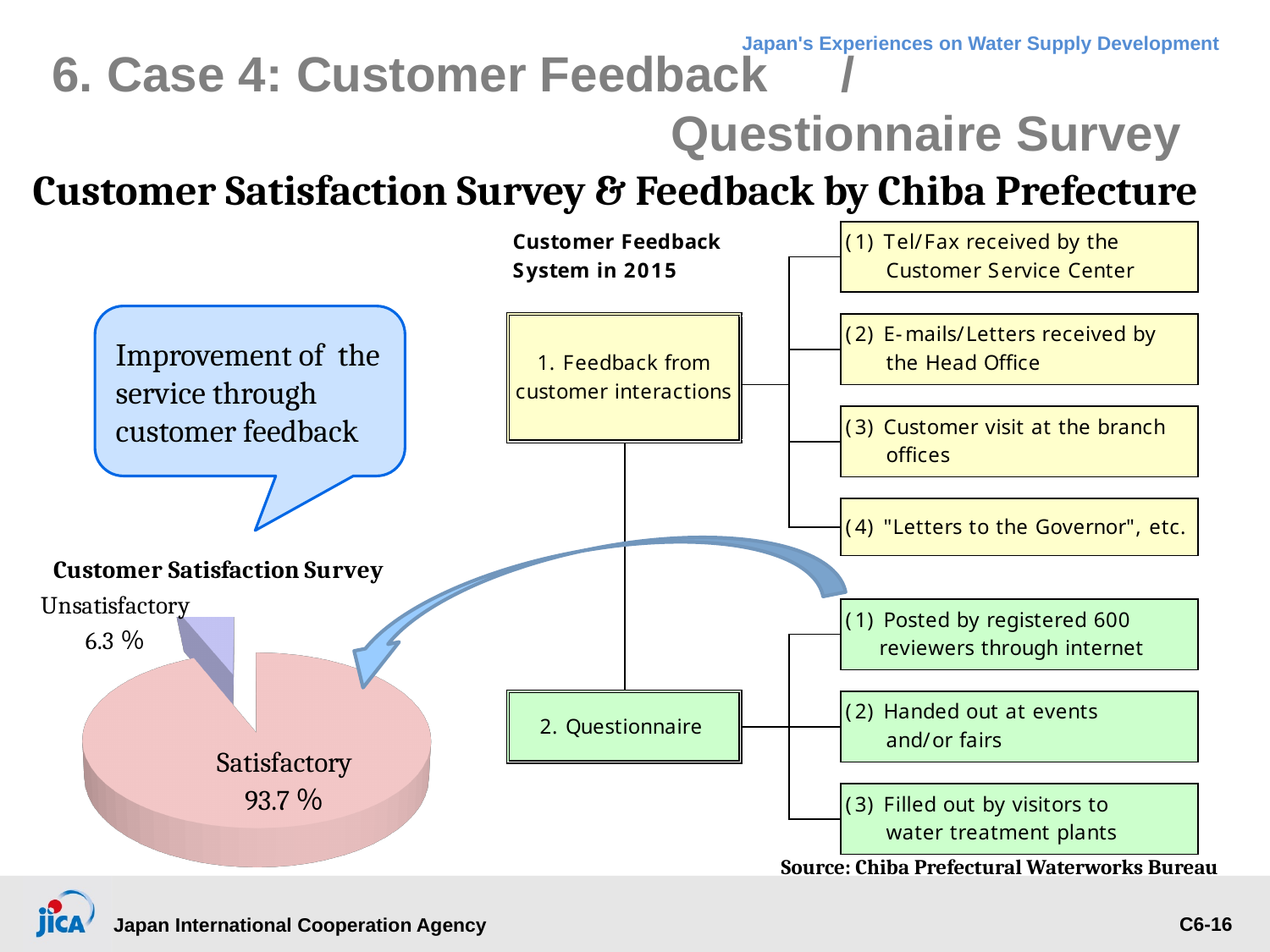
Which slice of the pie chart is the smallest? Unsatisfactory Is the Unsatisfactory share of the pie chart greater or less than 10%? less How many slices does the pie chart have? 2 What is the difference in percentage points between the Satisfactory and Unsatisfactory slices? 87.4 What is the title shown above the pie chart? Customer Satisfaction Survey What colour is the Satisfactory slice of the pie chart? pink Which is larger in the pie chart, Satisfactory or Unsatisfactory? Satisfactory Which slice of the pie chart is the largest? Satisfactory What share of the pie chart is labelled Unsatisfactory? 6.3 % What share of the pie chart is labelled Satisfactory? 93.7 % What kind of chart is shown under the heading "Customer Satisfaction Survey"? pie chart